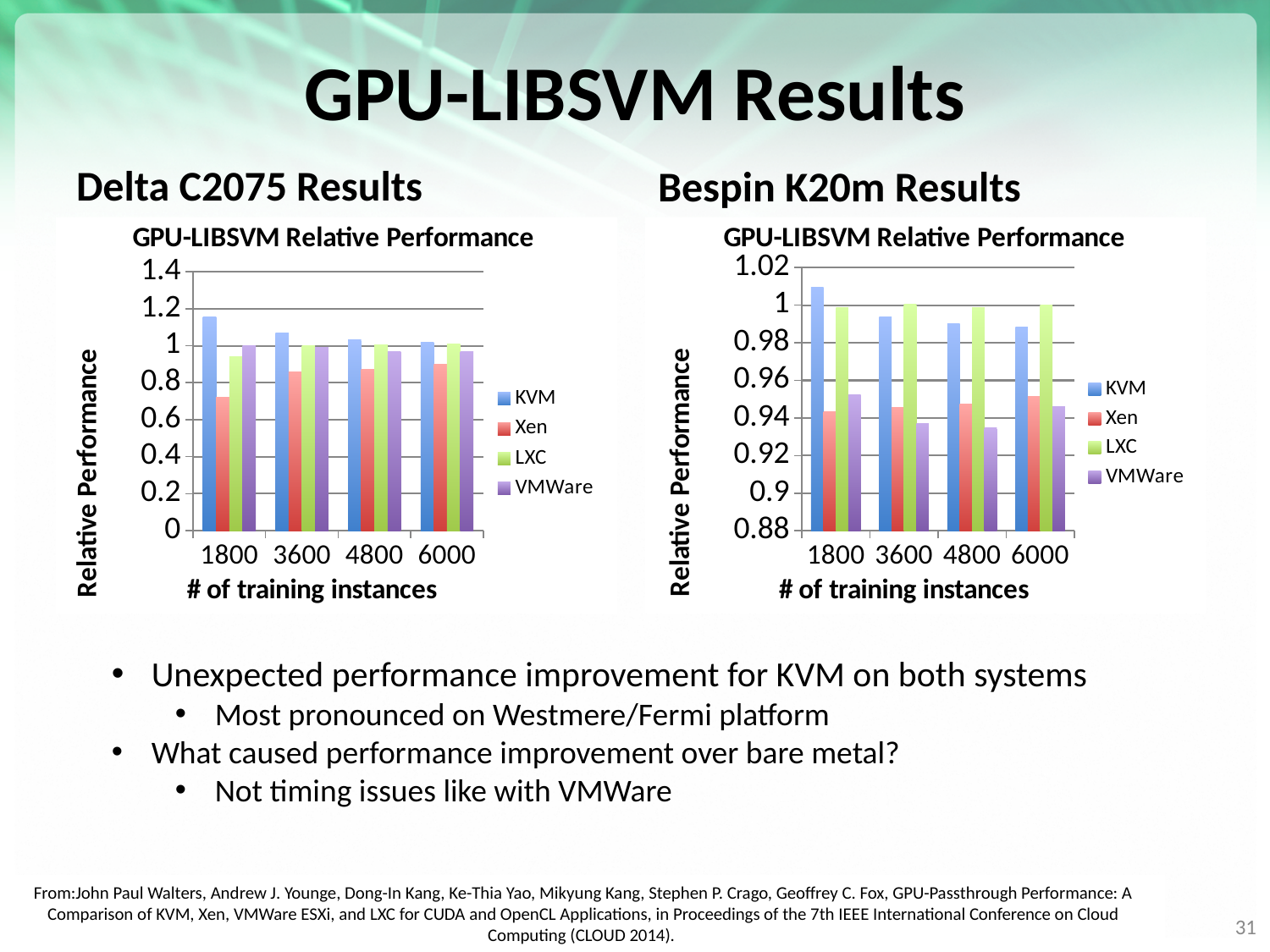
What is the x-axis title of the Bespin K20m Results chart on the right? # of training instances In the Delta C2075 Results chart on the left, which series has the highest value at 1800 training instances? KVM What kind of chart is the Delta C2075 Results chart on the left? bar chart In the Delta C2075 Results chart on the left, is the Xen value at 1800 training instances greater or less than 0.8? less How many training-instance categories are shown on the x axis of the Delta C2075 Results chart on the left? 4 In the Delta C2075 Results chart on the left, which series has the lowest value at 1800 training instances? Xen In the Delta C2075 Results chart on the left, does the Xen value rise or fall as the number of training instances increases from 1800 to 6000? rise How many series does the legend of the Bespin K20m Results chart on the right list? 4 In the Bespin K20m Results chart on the right, is the KVM value at 1800 training instances greater or less than 1? greater In the Delta C2075 Results chart on the left, is the KVM value at 1800 training instances greater or less than 1? greater In the Bespin K20m Results chart on the right, which is larger at 3600 training instances, Xen or VMWare? Xen In the Bespin K20m Results chart on the right, which series has the highest value at 1800 training instances? KVM